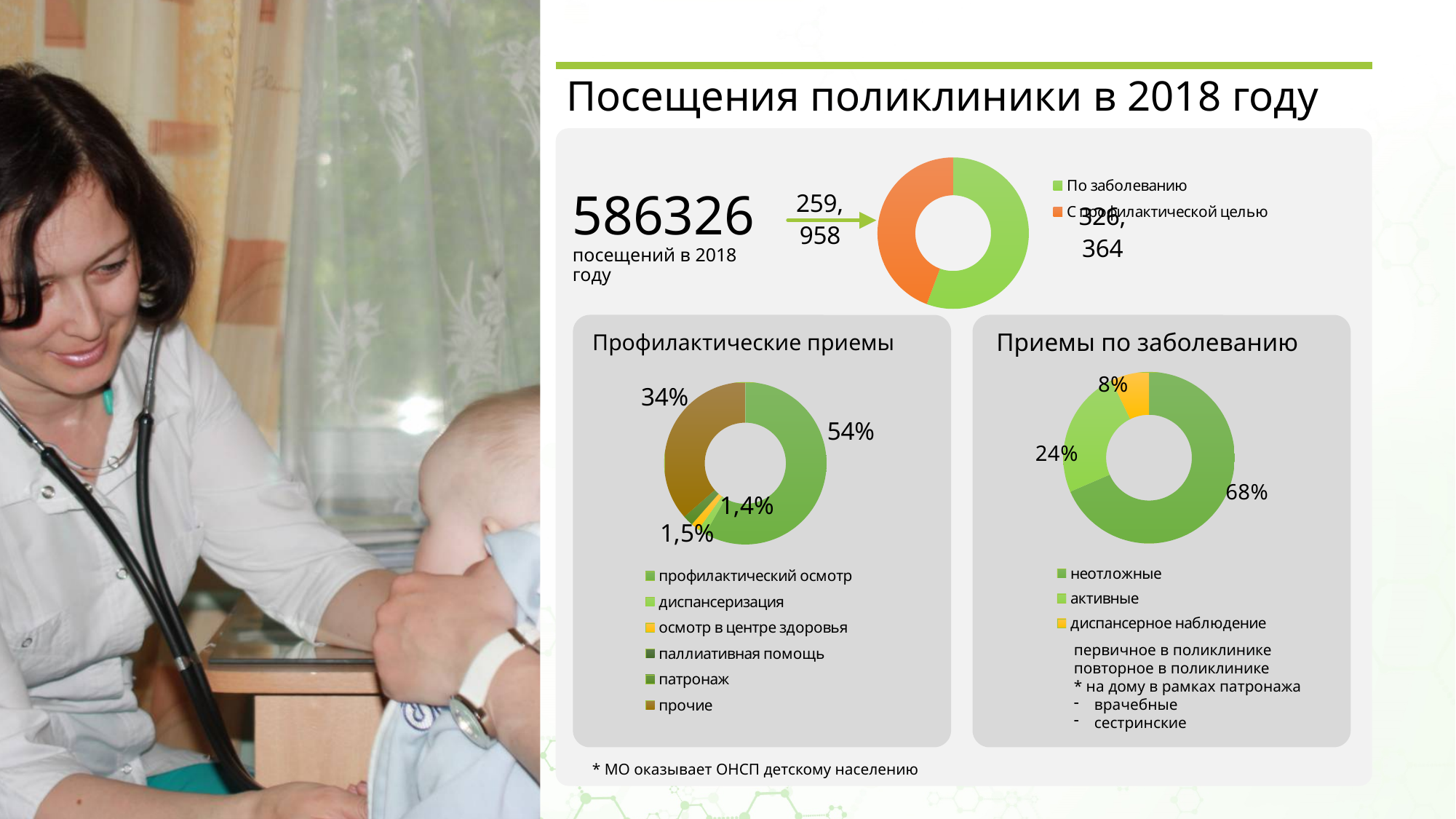
In the 'Приемы по заболеванию' chart, what is the difference in percentage points between неотложные and активные? 44 In the 'Профилактические приемы' chart, what percentage is shown for прочие? 34% In the 'Профилактические приемы' chart, how many categories does the legend list? 6 In the 'Приемы по заболеванию' chart, what percentage is shown for диспансерное наблюдение? 8% In the 'Профилактические приемы' chart, what percentage is shown for профилактический осмотр? 54% What kind of chart is used in the 'Приемы по заболеванию' panel? doughnut chart In the 'Приемы по заболеванию' chart, which category has the largest share? неотложные In the 'Приемы по заболеванию' chart, what percentage is shown for активные? 24% In the top chart next to the total 586326, which slice is larger: По заболеванию or С профилактической целью? По заболеванию In the 'Профилактические приемы' chart, which category has the largest share? профилактический осмотр In the 'Приемы по заболеванию' chart, what percentage is shown for неотложные? 68% In the 'Приемы по заболеванию' chart, which category has the smallest share? диспансерное наблюдение